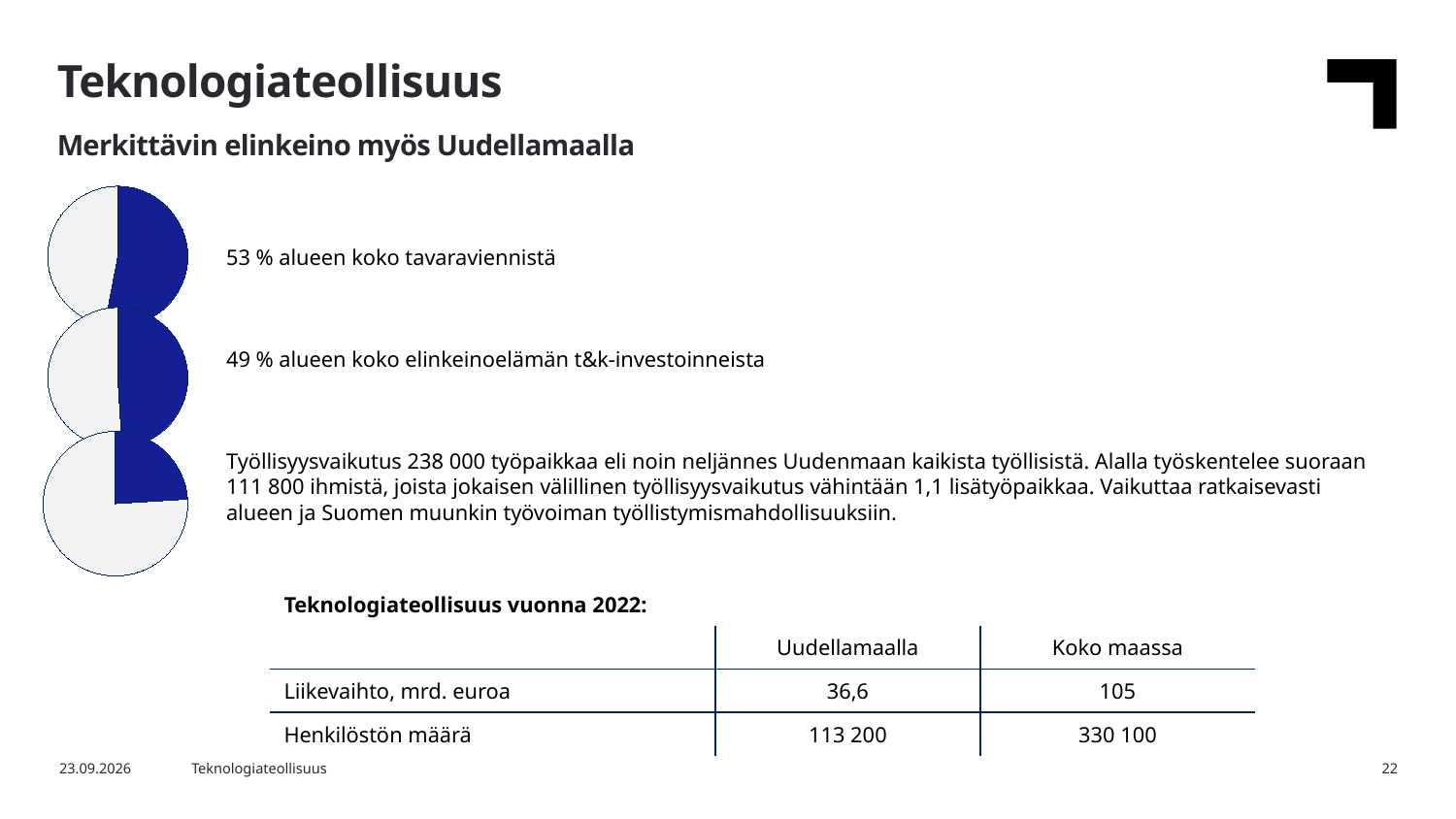
How many slices does each pie chart have? 2 What kind of charts are shown on the left side of the slide? Pie charts Which pie chart has the largest blue slice: the top, middle or bottom one? Top In the top pie chart, what share does the blue slice represent according to the text beside it? 53 % What colour is the highlighted slice in each pie chart? Blue In the middle pie chart, what share does the blue slice represent according to the text beside it? 49 % Is the blue slice larger in the top pie chart or in the bottom pie chart? Top pie chart What text is written next to the top pie chart? 53 % alueen koko tavaraviennistä In the top pie chart, is the blue slice larger or smaller than the grey slice? Larger How many pie charts are on the slide? 3 Which pie chart has the smallest blue slice: the top, middle or bottom one? Bottom In the bottom pie chart, is the blue slice larger or smaller than the grey slice? Smaller